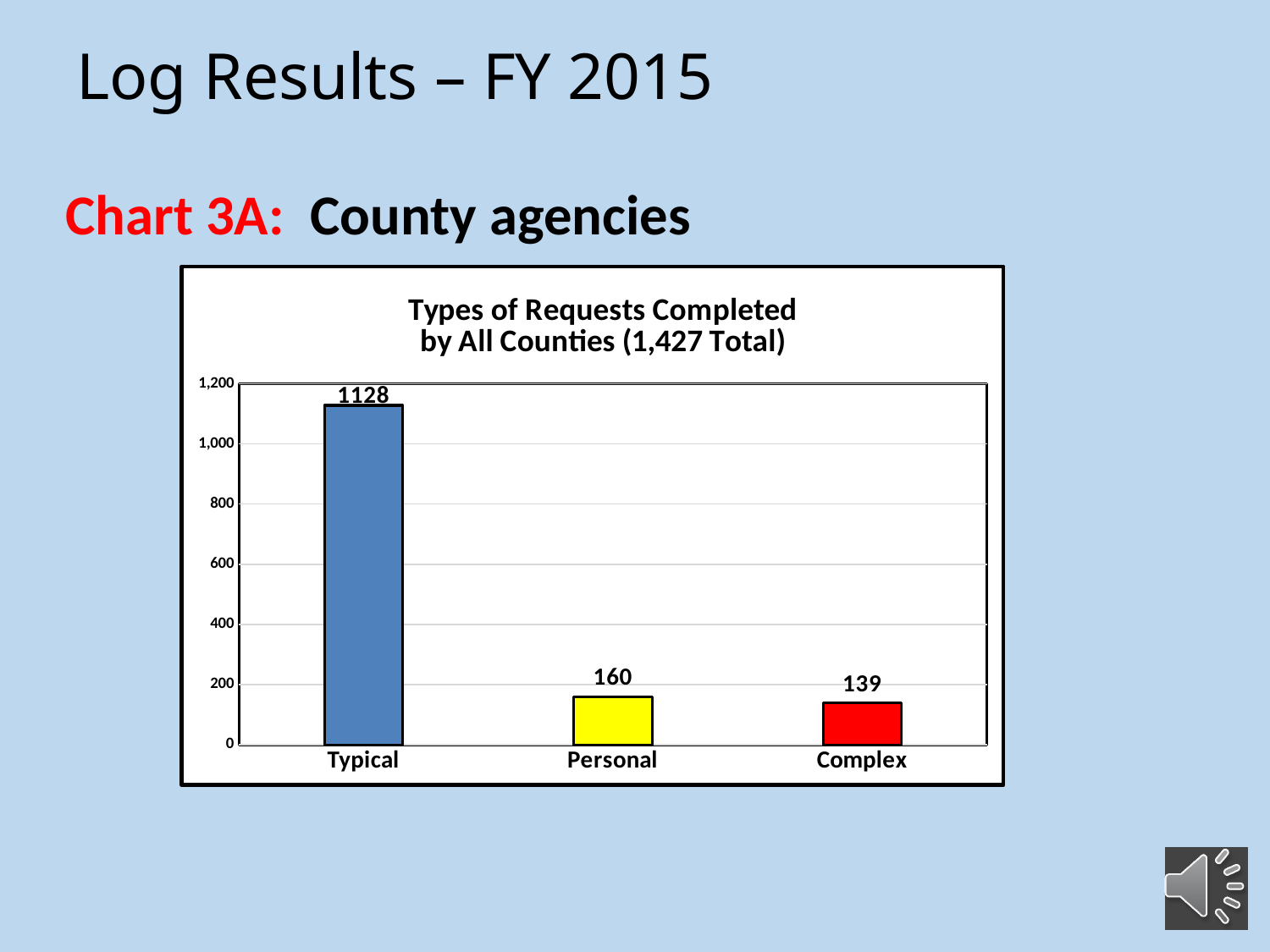
What is the title of the chart? Types of Requests Completed by All Counties (1,427 Total) Is the value for Typical greater or less than 1,000? greater What is the value for Typical? 1128 Which category has the lowest value? Complex What kind of chart is shown? bar chart What is the difference between the values for Typical and Personal? 968 How many categories are shown on the x axis? 3 What is the difference between the values for Personal and Complex? 21 What is the value for Complex? 139 Which category has the highest value? Typical Which is larger, the value for Personal or the value for Complex? Personal What is the value for Personal? 160